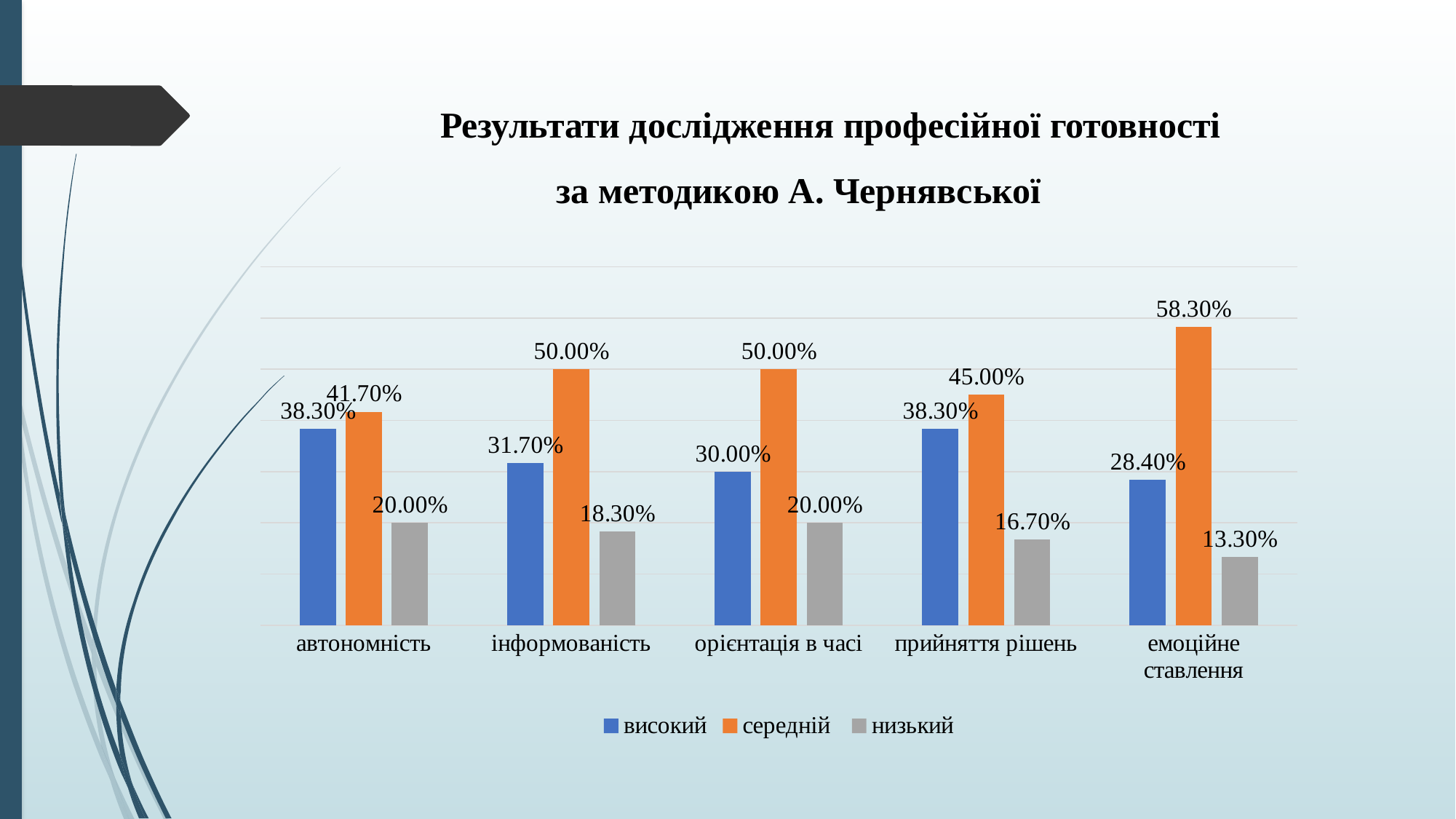
Which category has the lowest value in the високий series? емоційне ставлення Which category has the lowest value in the низький series? емоційне ставлення What is the value of the високий series for інформованість? 31.70% Which is larger for прийняття рішень: the високий value or the низький value? високий What is the value of the середній series for емоційне ставлення? 58.30% Which category has the highest value in the середній series? емоційне ставлення What is the value of the низький series for прийняття рішень? 16.70% What is the difference between the низький values for автономність and емоційне ставлення? 6.70% What is the difference between the середній and високий values for орієнтація в часі? 20.00% What kind of chart is shown on the slide? bar chart How many series does the legend list? 3 How many categories are shown on the x axis? 5